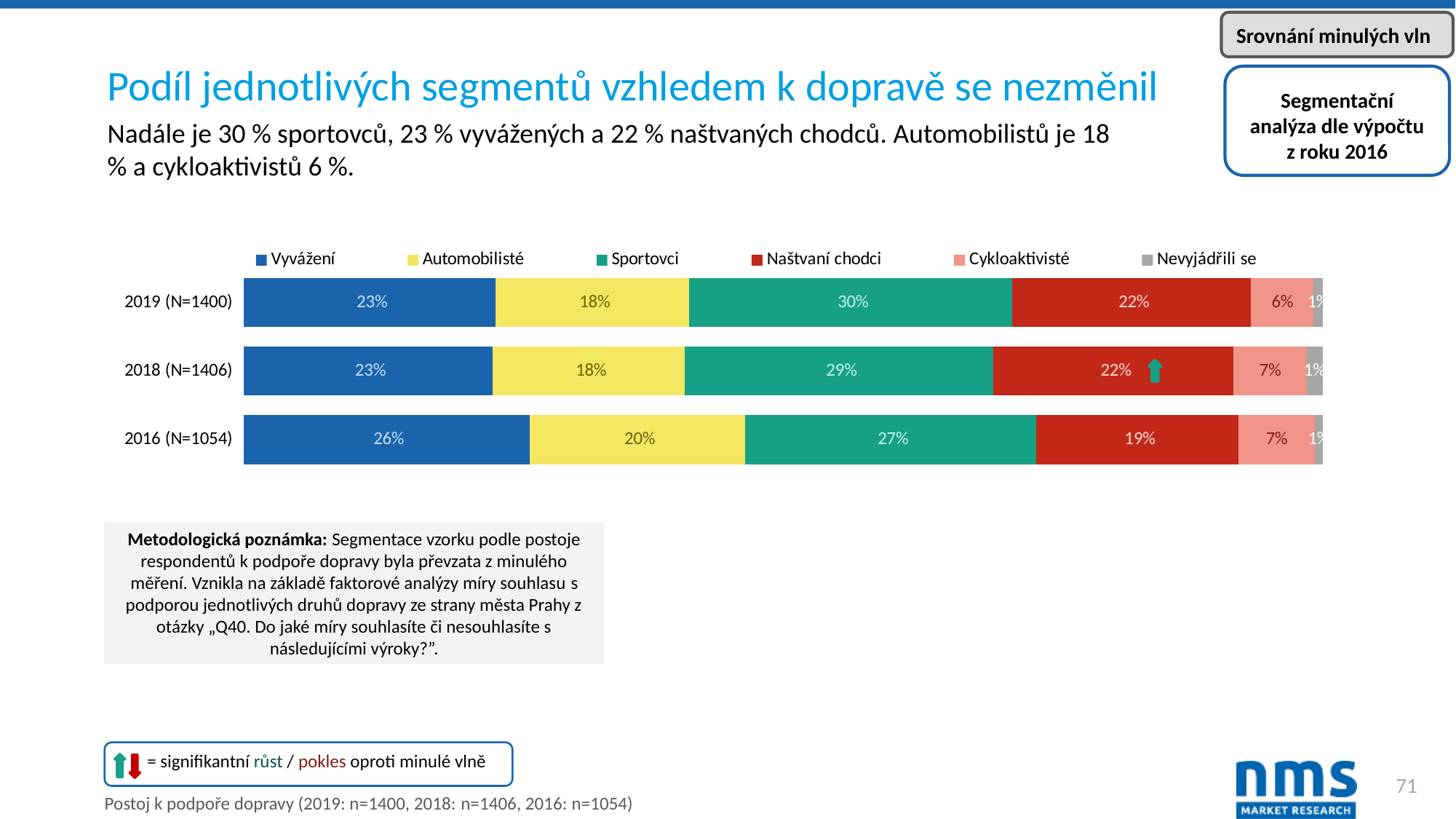
What is the value for Vyvážení in 2016 (N=1054)? 26% How many year bars are shown in the chart? 3 What is the difference between the Sportovci value in 2019 (N=1400) and in 2016 (N=1054)? 3% What is the value for Naštvaní chodci in 2016 (N=1054)? 19% Which segment has the smallest share in the 2016 (N=1054) bar? Nevyjádřili se What is the value for Sportovci in 2019 (N=1400)? 30% How many series does the legend list? 6 Which is larger: Automobilisté in 2016 (N=1054) or Automobilisté in 2019 (N=1400)? Automobilisté in 2016 (N=1054) Which series is shown in yellow in the chart? Automobilisté What is the value for Cykloaktivisté in 2018 (N=1406)? 7% Which segment has the largest share in the 2019 (N=1400) bar? Sportovci What kind of chart is shown on the slide? Stacked bar chart